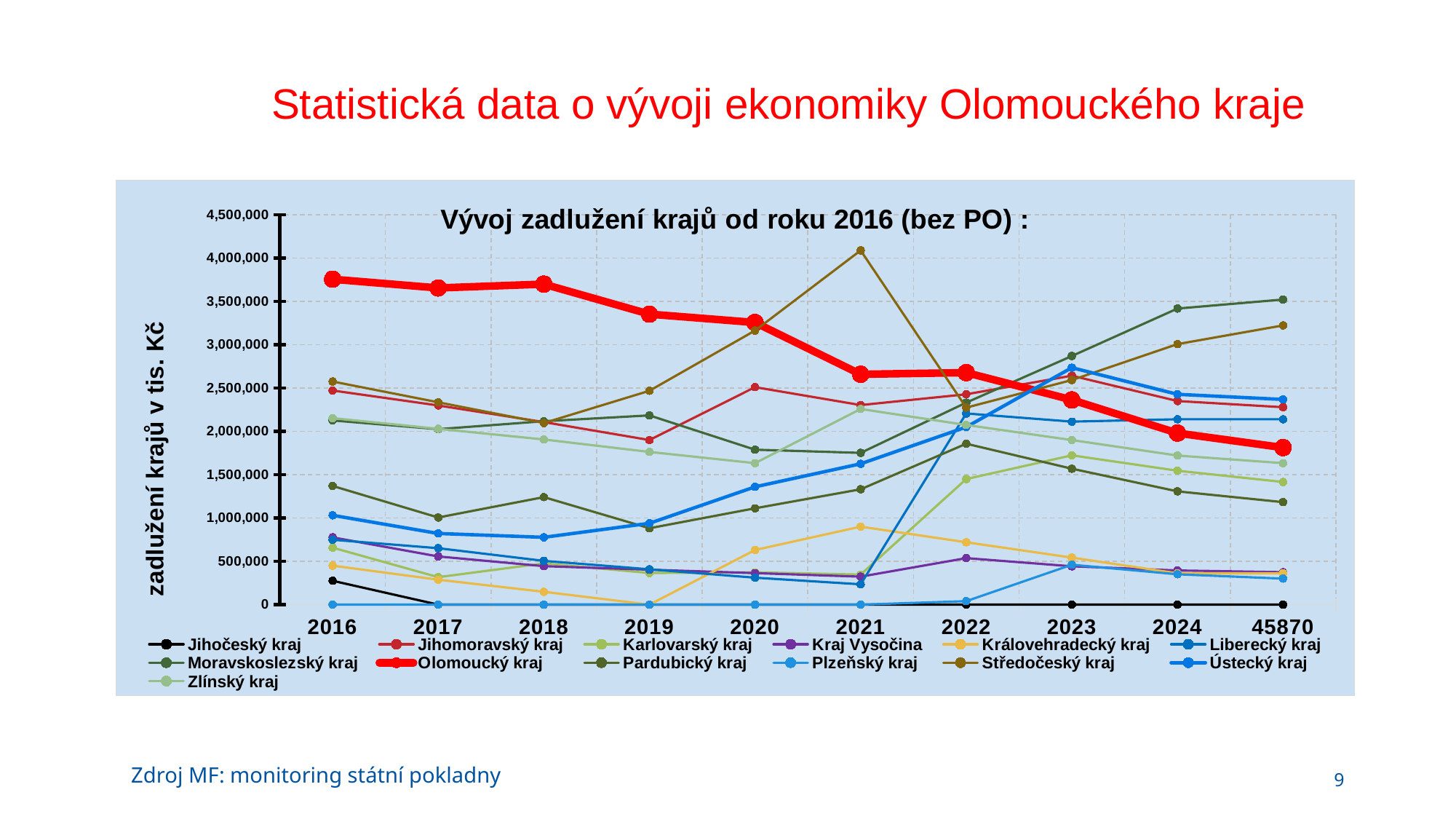
Which series has the highest value in 2021? Středočeský kraj Which is larger in 2021, the value for Středočeský kraj or the value for Olomoucký kraj? Středočeský kraj Which series has the highest value in 2016? Olomoucký kraj Is the value for Středočeský kraj in 2021 greater or less than 4,000,000? greater Is the value for Olomoucký kraj at the last point on the x axis (45870) greater or less than 2,000,000? less What is the label of the vertical axis? zadlužení krajů v tis. Kč Does the value for Olomoucký kraj rise or fall from 2016 to the last point on the x axis? fall What is the title of the chart? Vývoj zadlužení krajů od roku 2016 (bez PO) : How many points are there along the x axis? 10 What kind of chart is shown on the slide? line chart Is the value for Olomoucký kraj in 2016 greater or less than 3,500,000? greater How many series does the legend list? 13